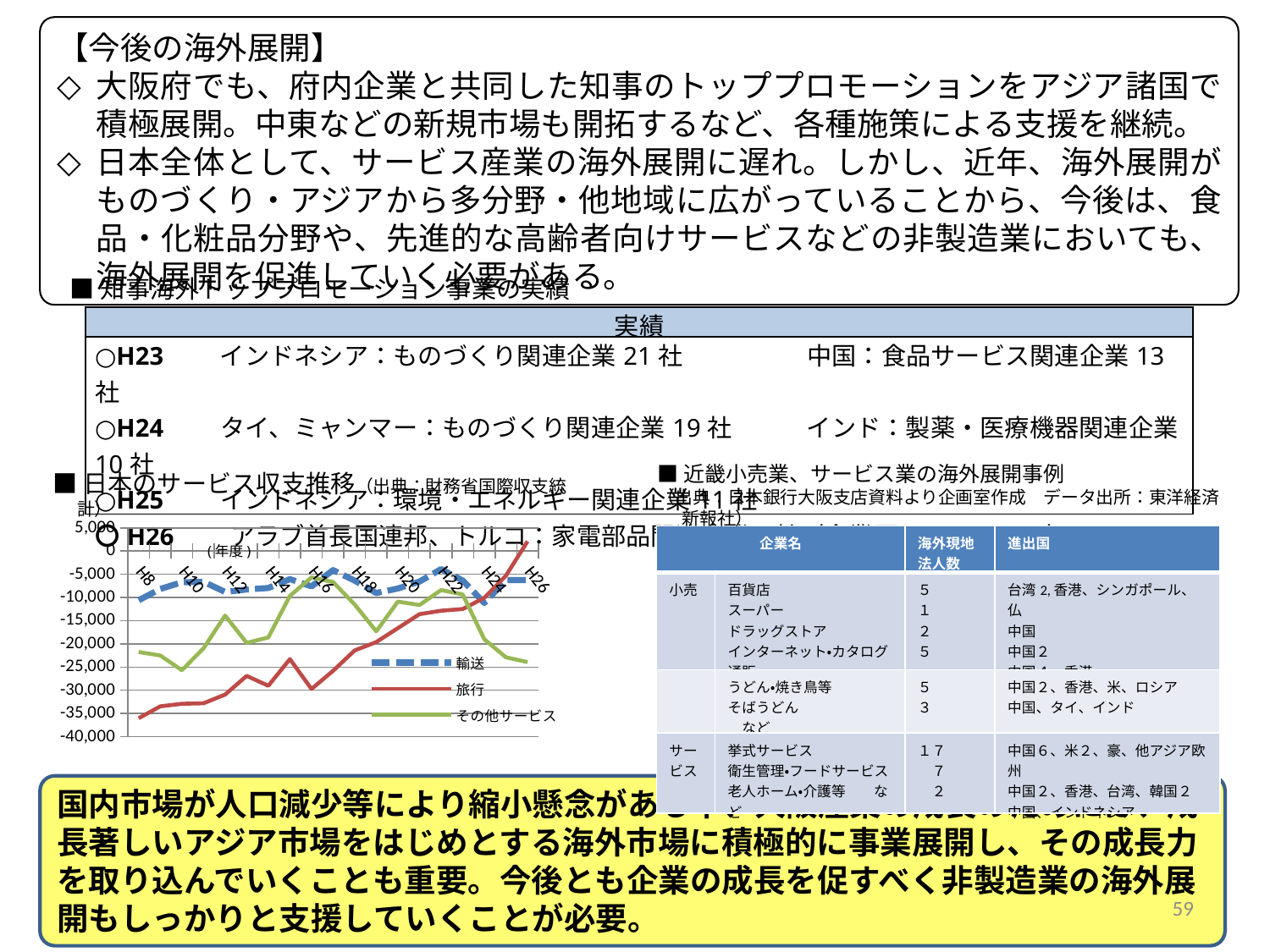
How many year labels are shown on the x axis of the 日本のサービス収支推移 chart? 10 In the 日本のサービス収支推移 chart, is the value for その他サービス at H26 greater or less than -20,000? less In the 日本のサービス収支推移 chart, which series has the lowest value at H8? 旅行 What kind of chart is 日本のサービス収支推移? line chart In the 日本のサービス収支推移 chart, which series is drawn as a dashed line? 輸送 In the 日本のサービス収支推移 chart, is the value for 旅行 at H8 greater or less than -30,000? less In the 日本のサービス収支推移 chart, does the 旅行 series rise or fall from H8 to H26? rise In the 日本のサービス収支推移 chart, is the value for 輸送 at H8 greater or less than -15,000? greater How many series does the legend of the 日本のサービス収支推移 chart list? 3 What are the three series named in the legend of the 日本のサービス収支推移 chart? 輸送, 旅行, その他サービス In the 日本のサービス収支推移 chart, at H26, which is larger: 旅行 or その他サービス? 旅行